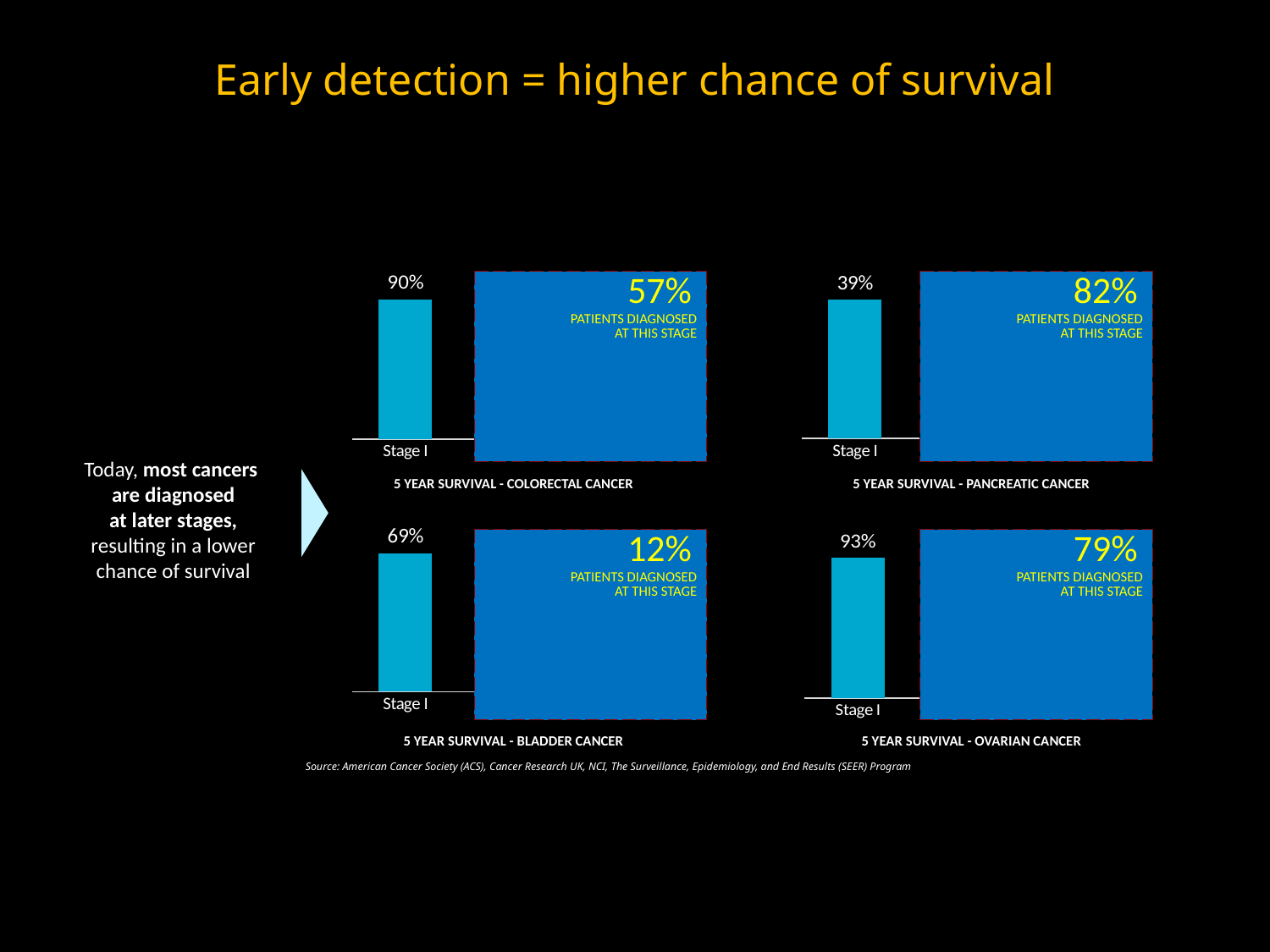
Across the four charts, which cancer has the lowest Stage I 5-year survival value? Pancreatic cancer What is the difference between the Stage I value in the ovarian cancer chart and the Stage I value in the bladder cancer chart? 24% How many bars are plotted in the '5 YEAR SURVIVAL - BLADDER CANCER' chart? 1 What is the category label on the x axis of the '5 YEAR SURVIVAL - OVARIAN CANCER' chart? Stage I What is the difference between the Stage I value in the colorectal cancer chart and the Stage I value in the pancreatic cancer chart? 51% Which is larger: the Stage I value in the bladder cancer chart or the Stage I value in the pancreatic cancer chart? Bladder cancer In the '5 YEAR SURVIVAL - OVARIAN CANCER' chart, what is the value shown for Stage I? 93% In the '5 YEAR SURVIVAL - PANCREATIC CANCER' chart, what is the value shown for Stage I? 39% In the '5 YEAR SURVIVAL - COLORECTAL CANCER' chart, what is the value shown for Stage I? 90% Across the four charts, which cancer has the highest Stage I 5-year survival value? Ovarian cancer What kind of chart is the '5 YEAR SURVIVAL - COLORECTAL CANCER' chart? Bar chart In the '5 YEAR SURVIVAL - BLADDER CANCER' chart, what is the value shown for Stage I? 69%